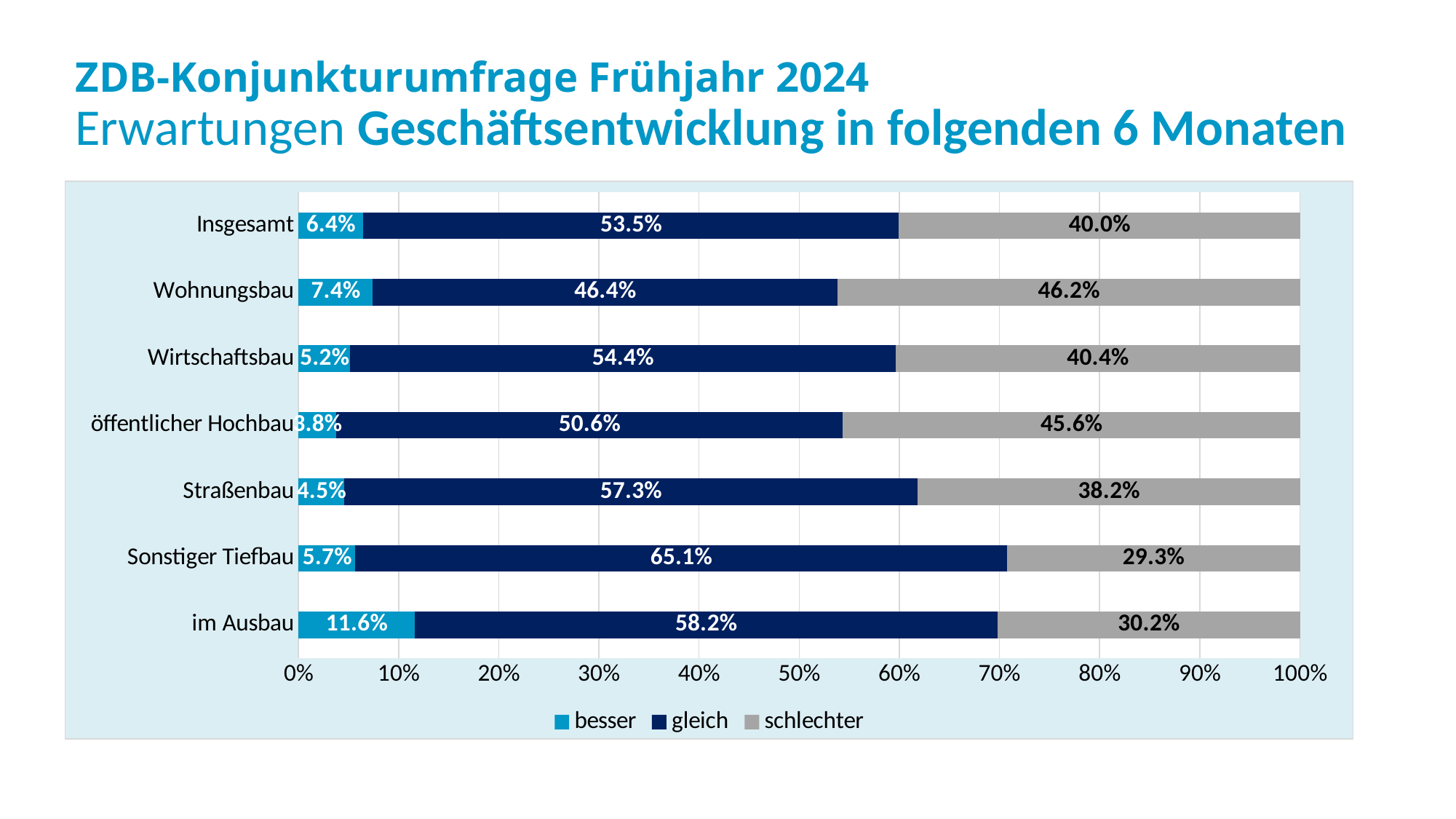
Which category has the highest 'besser' value? im Ausbau What is the 'gleich' value for Insgesamt? 53.5% What is the 'schlechter' value for Wohnungsbau? 46.2% How many categories are shown on the y axis? 7 What is the 'besser' value for im Ausbau? 11.6% Which is larger for Straßenbau: the 'gleich' value or the 'schlechter' value? gleich What is the 'gleich' value for Sonstiger Tiefbau? 65.1% How many series does the legend list? 3 Which category has the lowest 'schlechter' value? Sonstiger Tiefbau What kind of chart is shown on the slide? Stacked bar chart Which category has the highest 'gleich' value? Sonstiger Tiefbau What is the difference between the 'gleich' and 'schlechter' values for Insgesamt? 13.5 percentage points